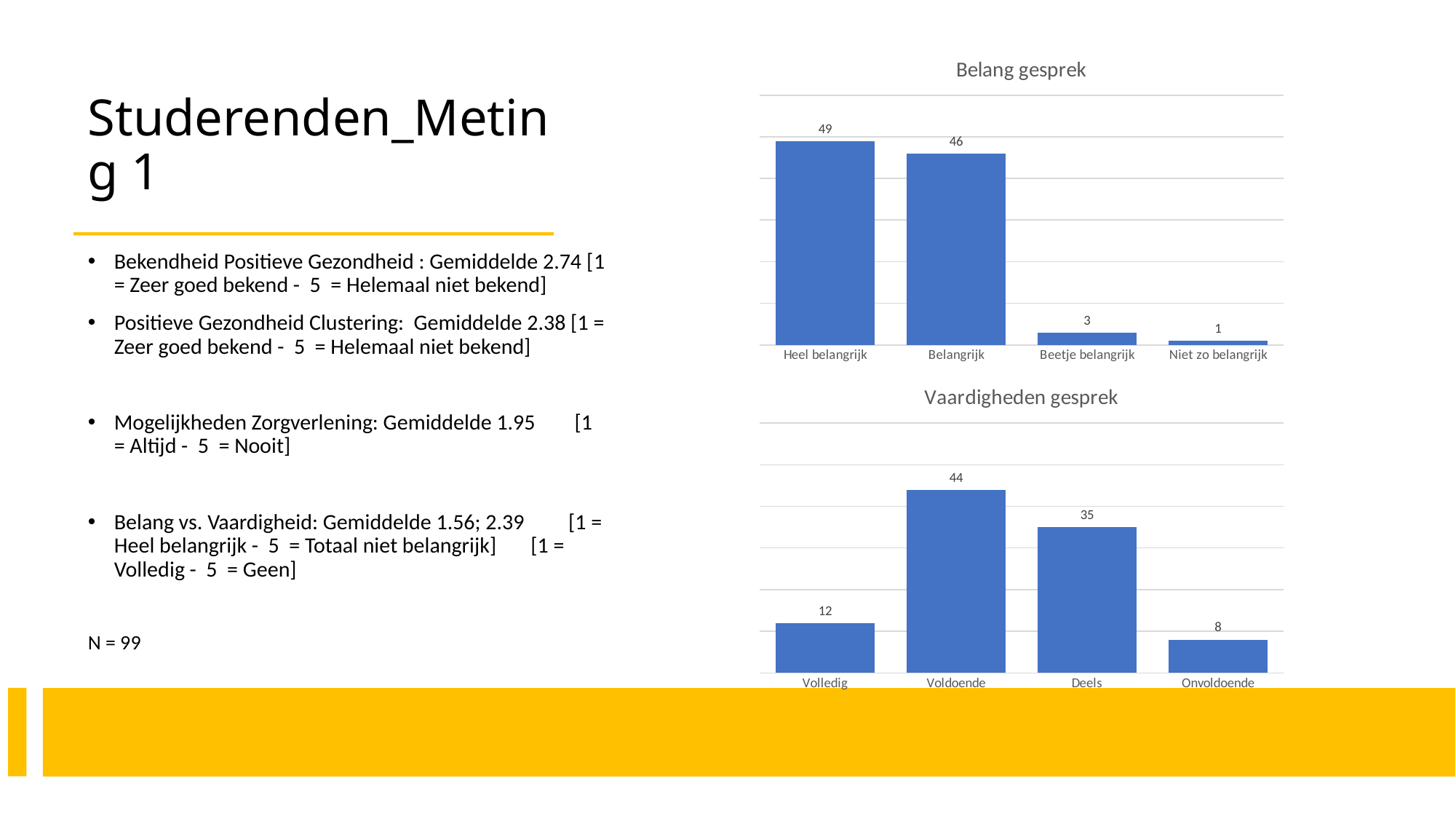
In the 'Vaardigheden gesprek' chart, what is the difference between 'Deels' and 'Volledig'? 23 What is the title of the top chart on the slide? Belang gesprek In the 'Vaardigheden gesprek' chart, what is the value for 'Onvoldoende'? 8 In the 'Belang gesprek' chart, what is the value for 'Beetje belangrijk'? 3 In the 'Vaardigheden gesprek' chart, what is the value for 'Voldoende'? 44 In the 'Belang gesprek' chart, what is the difference between 'Heel belangrijk' and 'Belangrijk'? 3 In the 'Belang gesprek' chart, how many categories are shown? 4 In the 'Belang gesprek' chart, which category has the lowest value? Niet zo belangrijk In the 'Vaardigheden gesprek' chart, which category has the highest value? Voldoende In the 'Belang gesprek' chart, what is the value for 'Heel belangrijk'? 49 What kind of chart is the 'Vaardigheden gesprek' chart? Bar chart In the 'Vaardigheden gesprek' chart, which is larger: 'Volledig' or 'Deels'? Deels